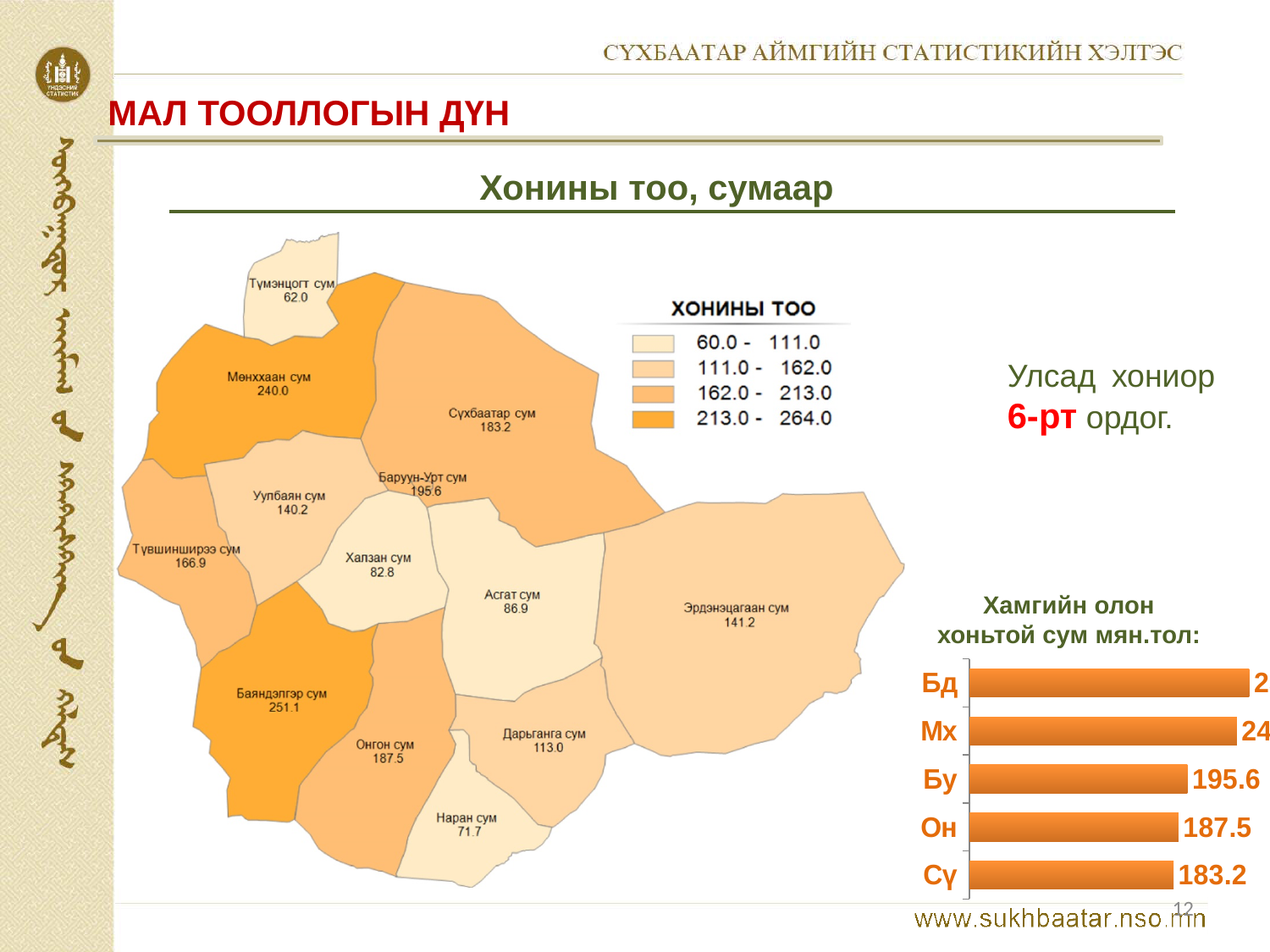
In the bar chart 'Хамгийн олон хоньтой сум мян.тол:', what is the value for Он? 187.5 In the bar chart 'Хамгийн олон хоньтой сум мян.тол:', how many categories are plotted? 5 In the bar chart 'Хамгийн олон хоньтой сум мян.тол:', what is the value for Сү? 183.2 On the map 'Хонины тоо, сумаар', what value is printed for Түмэнцогт сум? 62.0 In the bar chart 'Хамгийн олон хоньтой сум мян.тол:', what is the value for Бу? 195.6 In the bar chart 'Хамгийн олон хоньтой сум мян.тол:', which is larger, the value for Бу or the value for Сү? Бу In the bar chart 'Хамгийн олон хоньтой сум мян.тол:', which category has the lowest value? Сү In the bar chart 'Хамгийн олон хоньтой сум мян.тол:', do the bar values increase or decrease going from the top bar to the bottom bar? decrease In the bar chart 'Хамгийн олон хоньтой сум мян.тол:', what is the difference between the values for Бу and Он? 8.1 On the map 'Хонины тоо, сумаар', what value is printed for Баяндэлгэр сум? 251.1 What kind of chart is shown at the bottom right of the slide under 'Хамгийн олон хоньтой сум мян.тол:'? bar chart In the bar chart 'Хамгийн олон хоньтой сум мян.тол:', what is the difference between the values for Он and Сү? 4.3